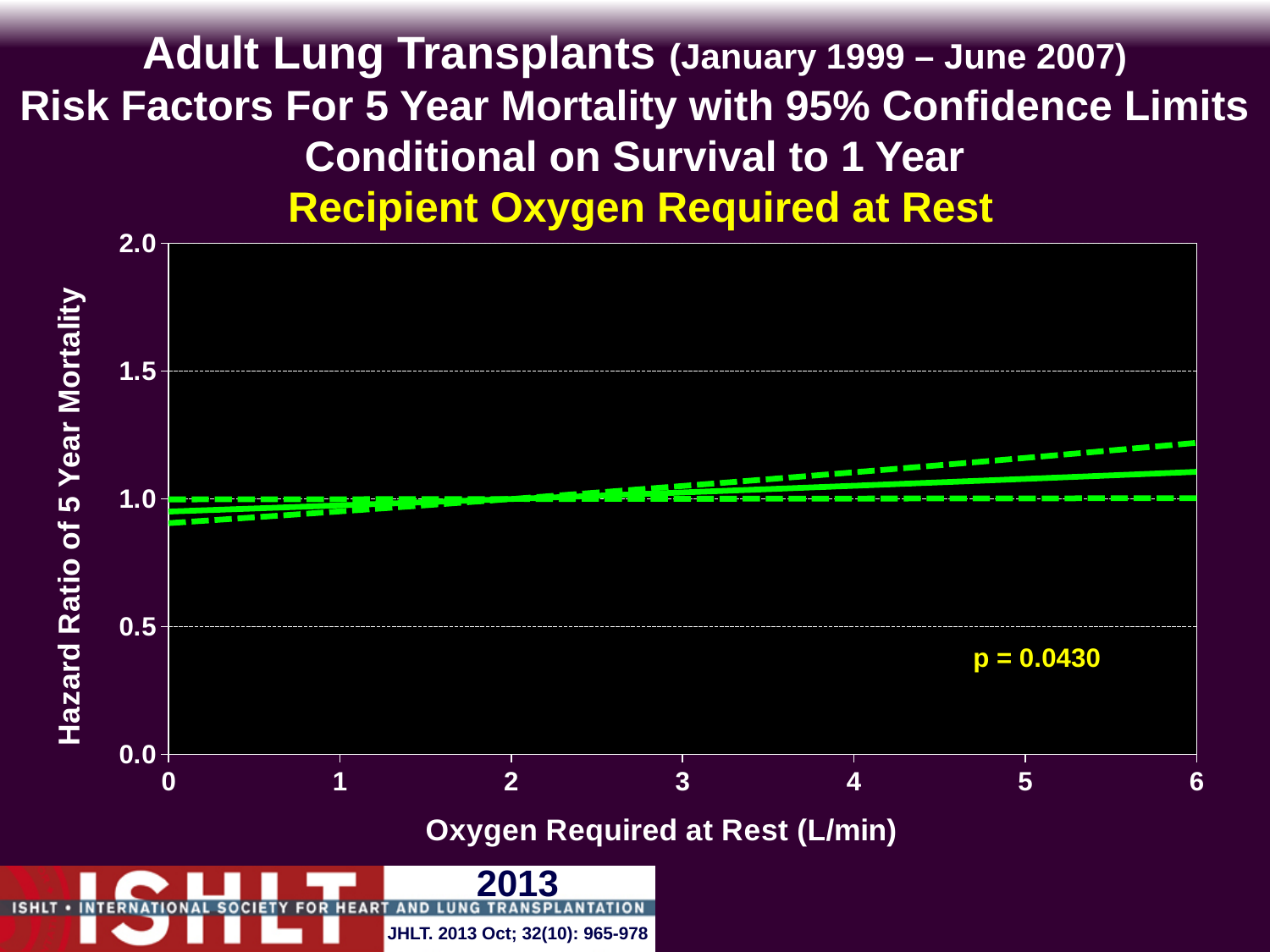
Is the hazard ratio at 6 L/min of oxygen required at rest greater or less than 1.5? less Is the upper 95% confidence limit at 6 L/min greater or less than 1.0? greater Is the lower 95% confidence limit at 0 L/min greater or less than 1.0? less What is the label of the x axis? Oxygen Required at Rest (L/min) What kind of chart is shown on the slide? line chart Does the hazard ratio of 5 year mortality rise or fall as oxygen required at rest increases from 0 to 6 L/min? rise What p-value is printed on the chart? p = 0.0430 What is the highest value shown on the y axis? 2.0 How many lines are plotted on the chart (the estimate plus its confidence limits)? 3